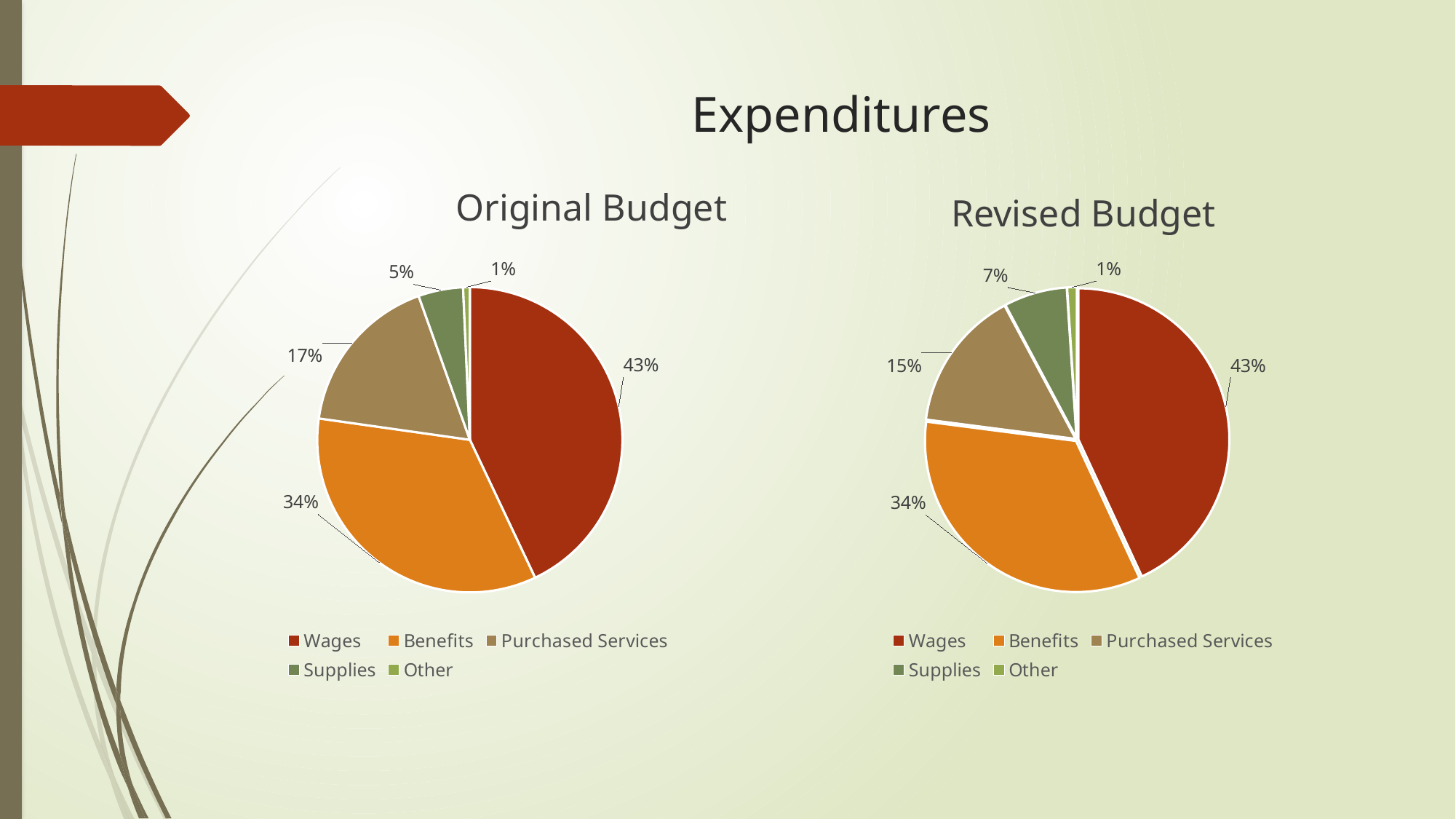
In the Original Budget chart, what share of expenditures is Supplies? 5% What kind of chart is the Original Budget chart? Pie chart In the Revised Budget chart, which category has the smallest slice? Other In the Original Budget chart, which is larger, the Benefits slice or the Purchased Services slice? Benefits How many categories does the Revised Budget chart show? 5 In the Original Budget chart, what share of expenditures is Wages? 43% In the Original Budget chart, which category has the largest slice? Wages In the Revised Budget chart, what share of expenditures is Purchased Services? 15% What is the title of the slide containing the two charts? Expenditures What is the difference between the Purchased Services share in the Original Budget chart and in the Revised Budget chart? 2%